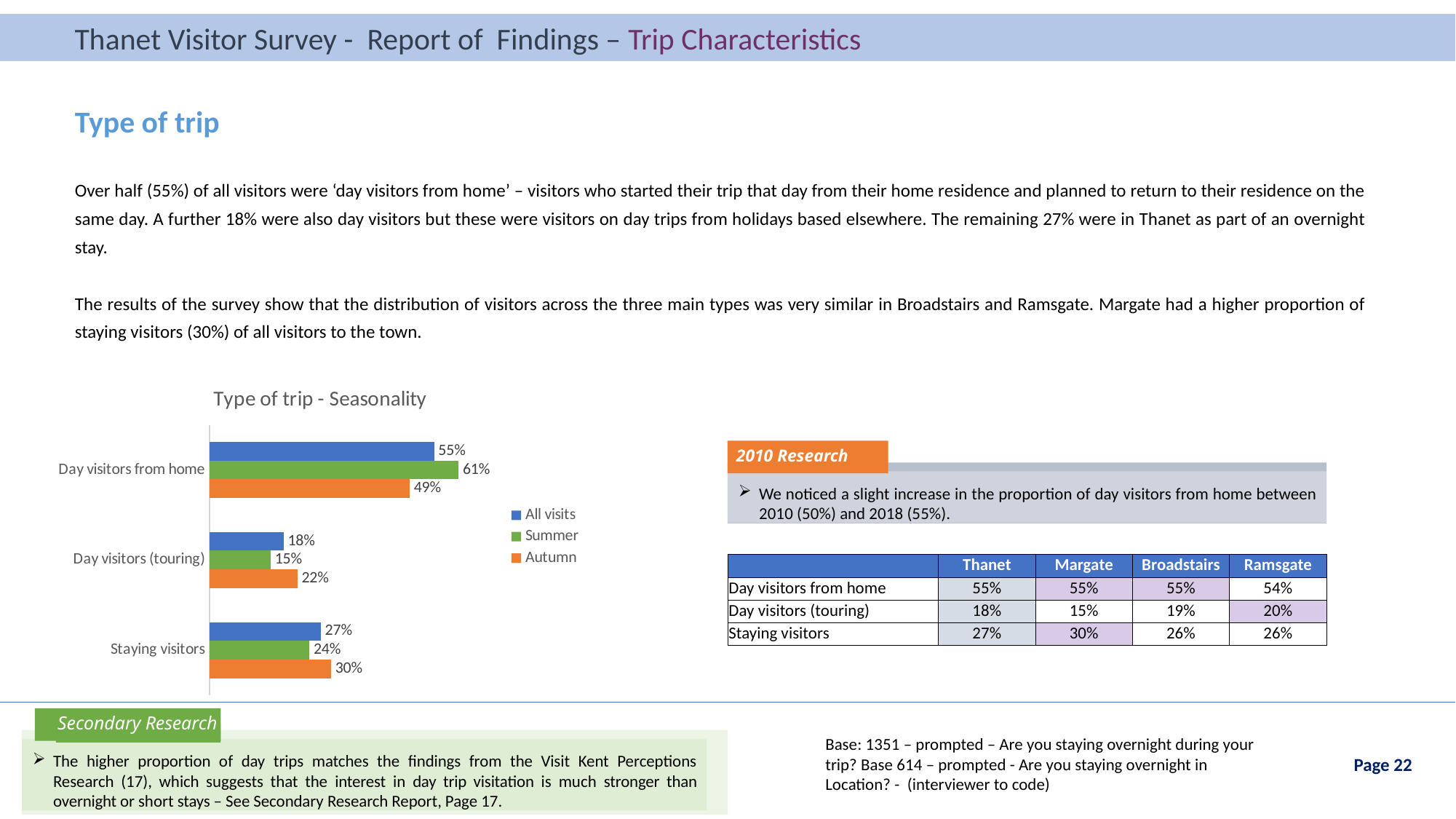
What is the Autumn value for 'Day visitors (touring)' in the 'Type of trip - Seasonality' chart? 22% How many categories are shown on the 'Type of trip - Seasonality' chart? 3 What kind of chart is 'Type of trip - Seasonality'? bar chart In the 'Type of trip - Seasonality' chart, is the Autumn value for 'Staying visitors' larger or smaller than the Summer value? larger In the 'Type of trip - Seasonality' chart, which category has the lowest Summer value? Day visitors (touring) How many series does the legend of the 'Type of trip - Seasonality' chart list? 3 What is the title of the chart on the slide? Type of trip - Seasonality Which colour represents the Autumn series in the 'Type of trip - Seasonality' chart? orange In the 'Type of trip - Seasonality' chart, what is the difference between the Summer and Autumn values for 'Day visitors from home'? 12% What is the Summer value for 'Day visitors from home' in the 'Type of trip - Seasonality' chart? 61% What is the All visits value for 'Staying visitors' in the 'Type of trip - Seasonality' chart? 27% In the 'Type of trip - Seasonality' chart, which category has the highest All visits value? Day visitors from home